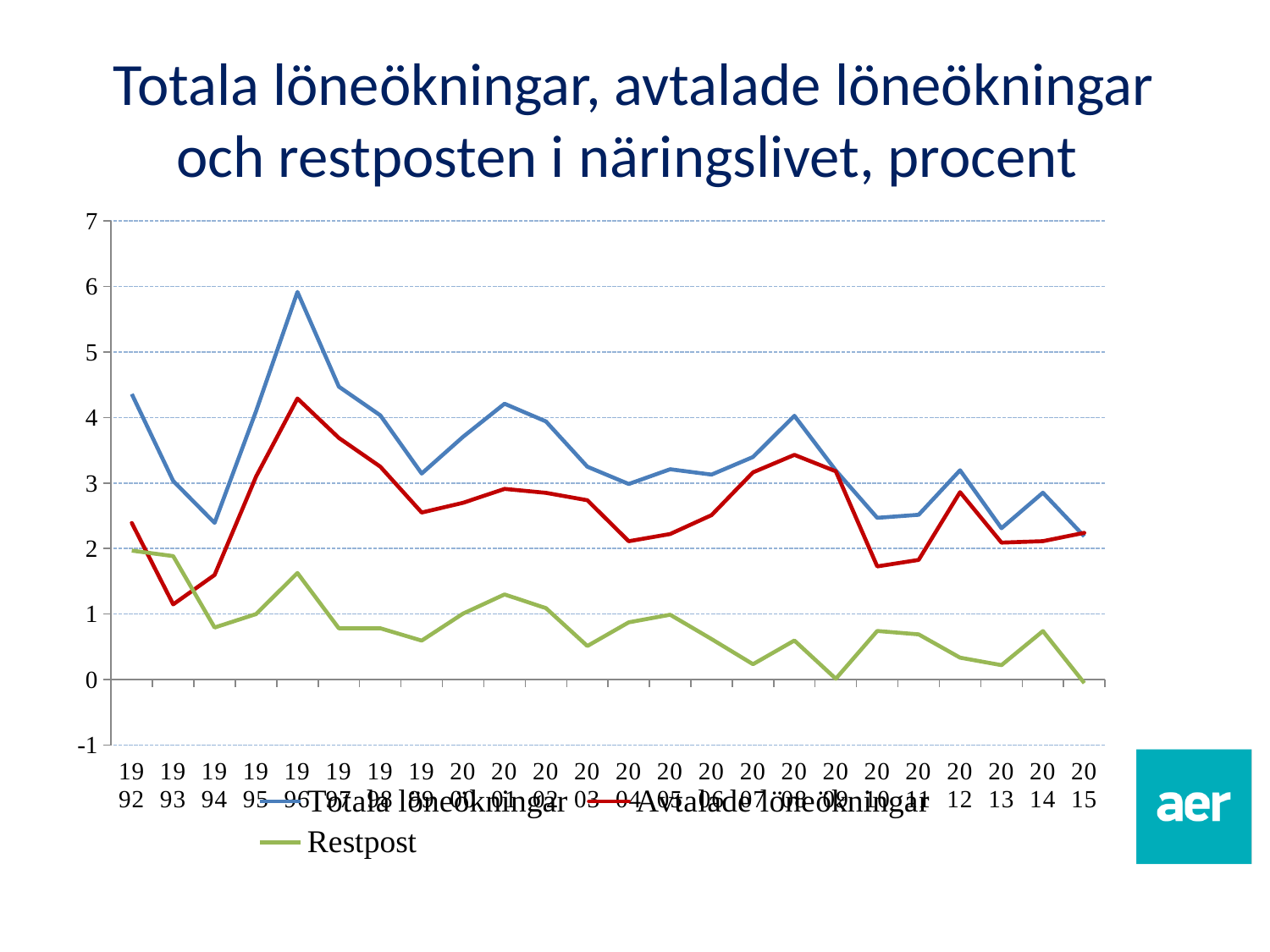
Is the value for Totala löneökningar in 1996 greater or less than 5? greater Which series is drawn in green? Restpost In 1996, which series has the larger value: Totala löneökningar or Avtalade löneökningar? Totala löneökningar How many series does the legend list? 3 Is the value for Totala löneökningar in 1994 greater or less than 3? less What kind of chart is shown on the slide? line chart In which year does the Totala löneökningar series reach its highest value? 1996 Is the value for Avtalade löneökningar in 1993 greater or less than 2? less How many years are plotted along the x axis? 24 In which year does the Avtalade löneökningar series reach its lowest value? 1993 Does the Restpost series overall rise or fall from 1992 to 2015? fall